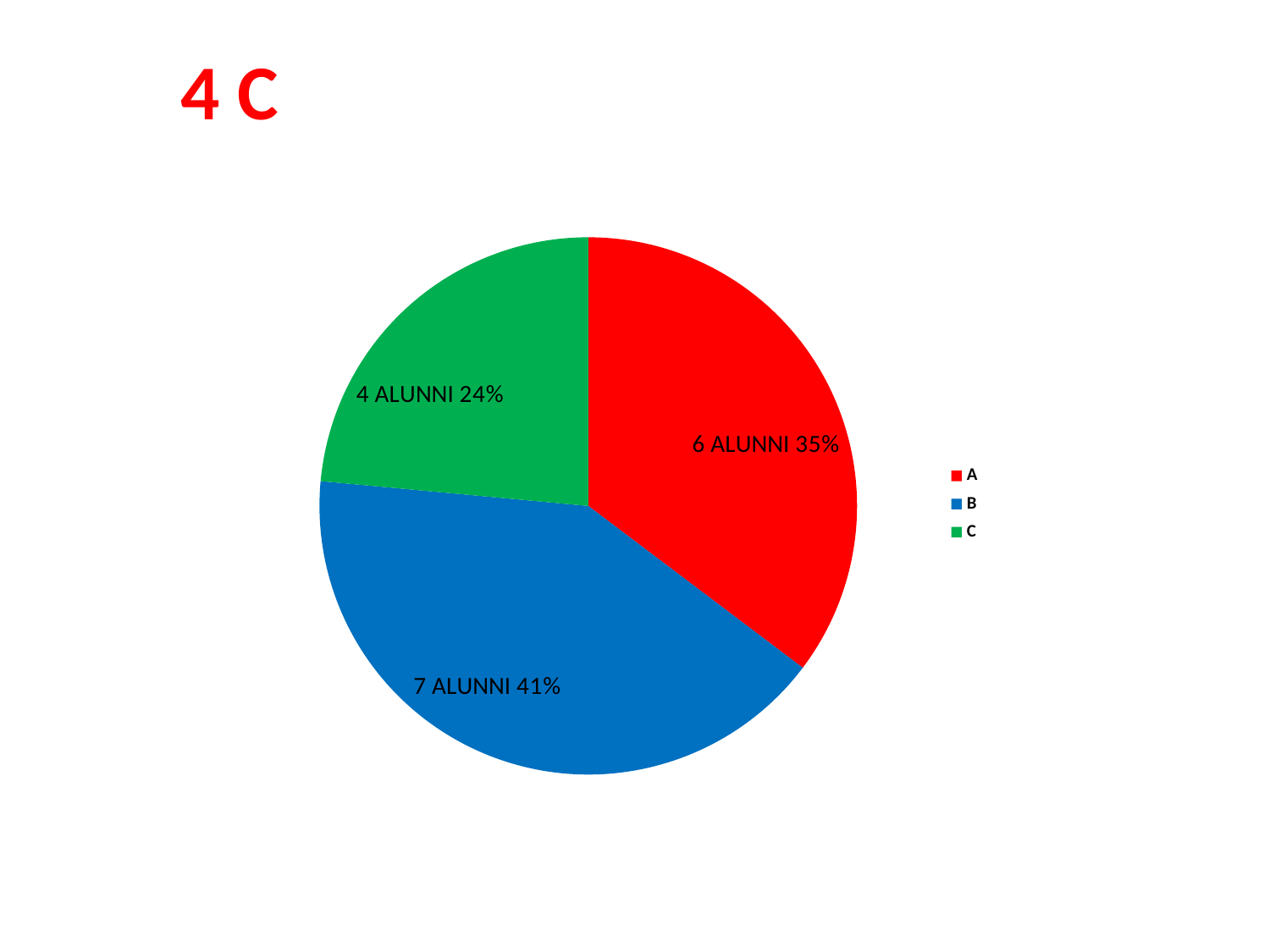
How many slices does the pie chart have? 3 Which category has the smallest slice? C Which category has the largest slice? B What percentage share does slice B have? 41% How many alunni are in category A? 6 What percentage share does slice A have? 35% What percentage share does slice C have? 24% What is the difference in alunni between category B and category C? 3 How many entries does the legend list? 3 How many alunni are in category B? 7 What kind of chart is shown on the slide? pie chart How many alunni are in category C? 4